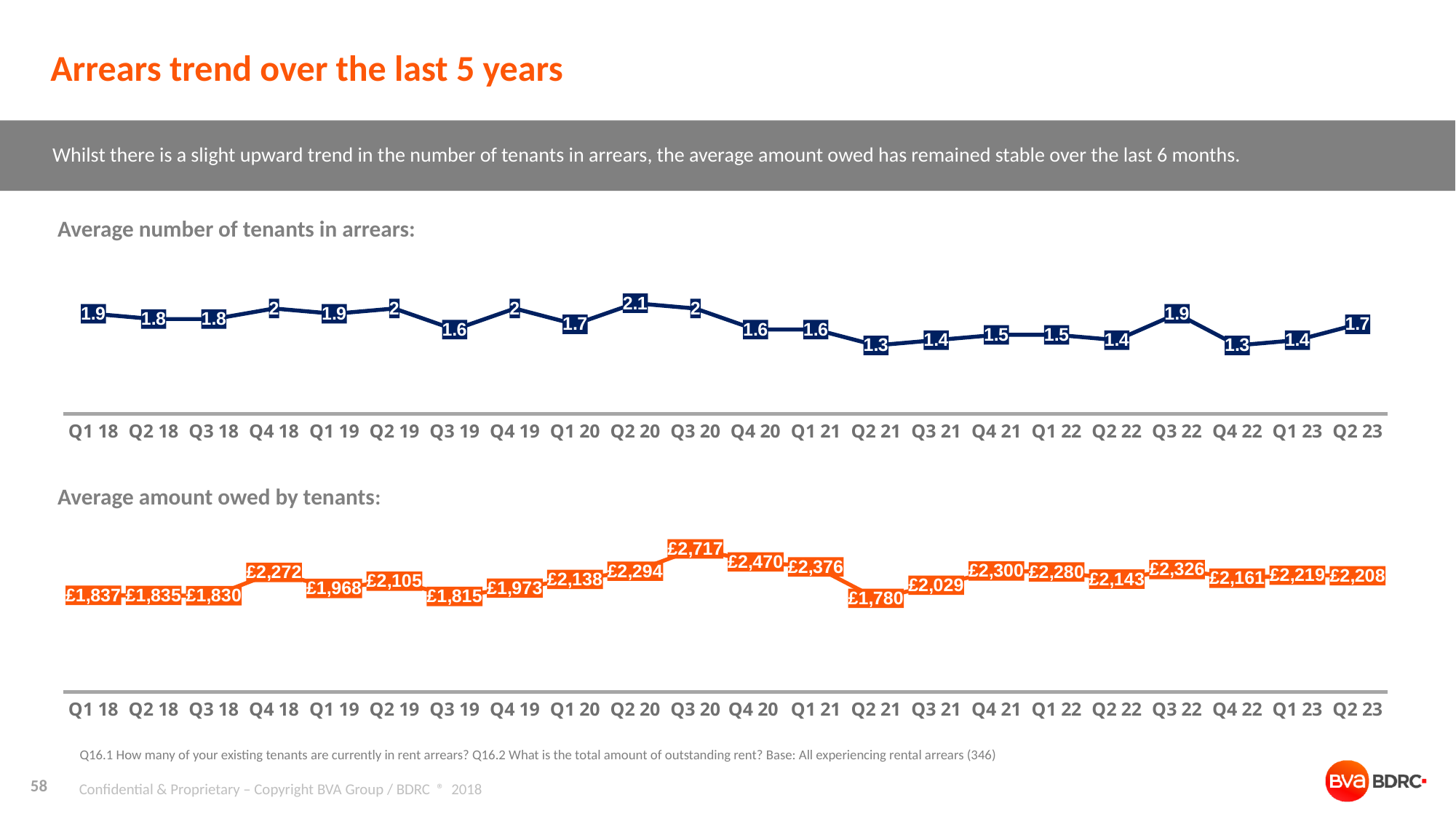
In the 'Average number of tenants in arrears' chart, what is the value for Q2 20? 2.1 In the 'Average number of tenants in arrears' chart, what is the difference between Q3 22 and Q4 22? 0.6 In the 'Average amount owed by tenants' chart, what is the value for Q2 23? £2,208 In the 'Average amount owed by tenants' chart, which quarter has the lowest value? Q2 21 In the 'Average amount owed by tenants' chart, what is the value for Q3 20? £2,717 In the 'Average number of tenants in arrears' chart, what is the value for Q2 23? 1.7 How many quarters are plotted in the 'Average number of tenants in arrears' chart? 22 In the 'Average amount owed by tenants' chart, which quarter has the highest value? Q3 20 In the 'Average amount owed by tenants' chart, which is larger, the value for Q4 18 or the value for Q1 19? Q4 18 In the 'Average amount owed by tenants' chart, what is the difference between Q3 20 and Q4 20? £247 What type of chart is used for 'Average amount owed by tenants'? Line chart In the 'Average number of tenants in arrears' chart, which quarter has the highest value? Q2 20